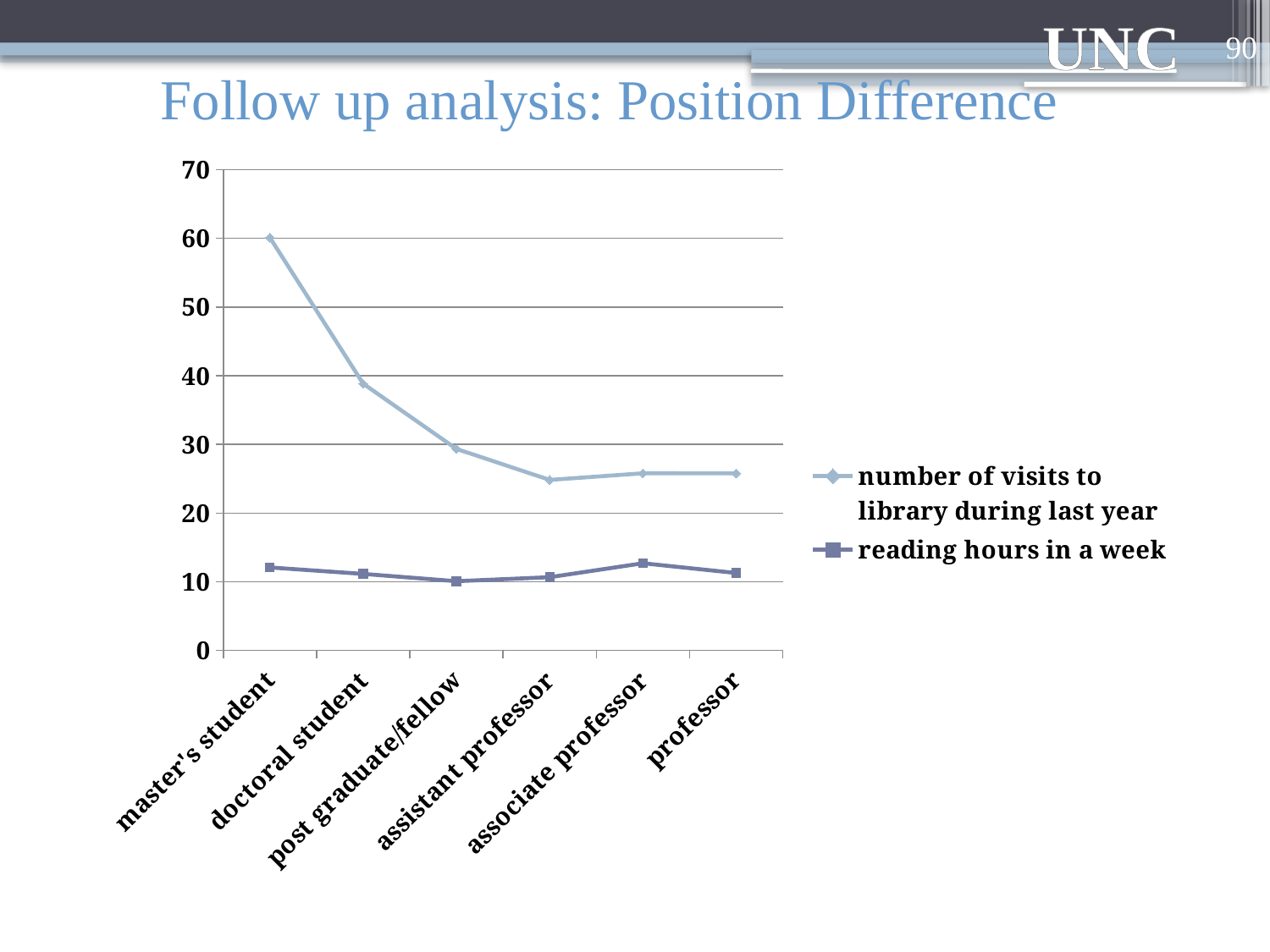
Is the value of reading hours in a week for master's student greater or less than 20? less Is the number of visits to library during last year for professor greater or less than 30? less Does the number of visits to library during last year rise or fall from master's student to assistant professor? fall What kind of chart is shown on the slide? line chart How many series does the legend list? 2 For professor, which series has the larger value, number of visits to library during last year or reading hours in a week? number of visits to library during last year How many position categories are plotted along the x axis? 6 Which position has the highest reading hours in a week? associate professor Which has more visits to library during last year, master's student or doctoral student? master's student Which position has the highest number of visits to library during last year? master's student